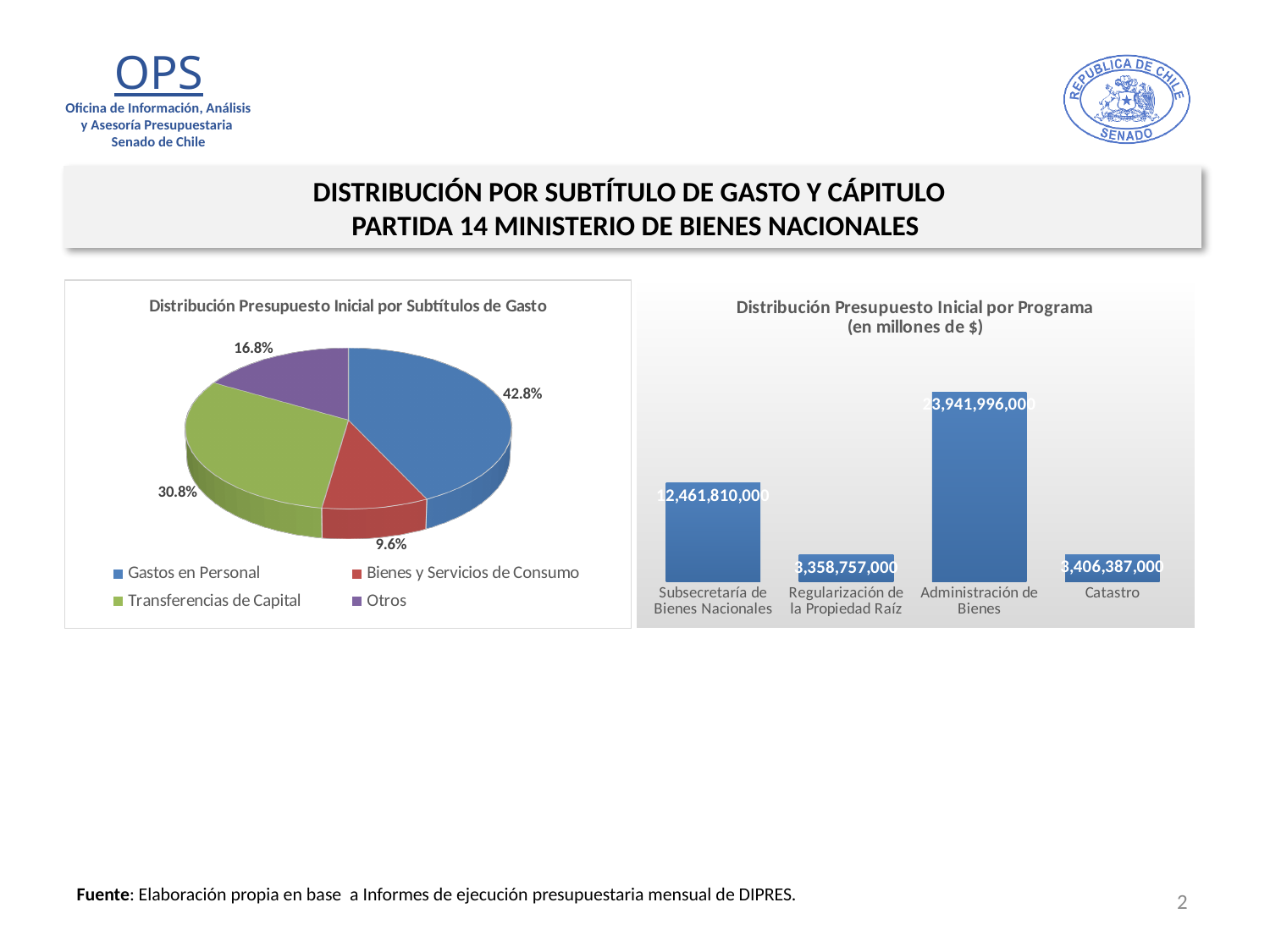
In the pie chart 'Distribución Presupuesto Inicial por Subtítulos de Gasto', which colour represents Transferencias de Capital? Green In the pie chart 'Distribución Presupuesto Inicial por Subtítulos de Gasto', what share does Transferencias de Capital have? 30.8% In the pie chart 'Distribución Presupuesto Inicial por Subtítulos de Gasto', which category has the largest share? Gastos en Personal How many programs are shown in the bar chart 'Distribución Presupuesto Inicial por Programa'? 4 In the pie chart 'Distribución Presupuesto Inicial por Subtítulos de Gasto', what share does Gastos en Personal have? 42.8% In the pie chart 'Distribución Presupuesto Inicial por Subtítulos de Gasto', how many percentage points larger is Gastos en Personal than Transferencias de Capital? 12.0 percentage points In the bar chart 'Distribución Presupuesto Inicial por Programa', which is larger: Subsecretaría de Bienes Nacionales or Administración de Bienes? Administración de Bienes In the pie chart 'Distribución Presupuesto Inicial por Subtítulos de Gasto', what share does Otros have? 16.8% What kind of chart is 'Distribución Presupuesto Inicial por Programa'? Bar chart How many slices does the pie chart 'Distribución Presupuesto Inicial por Subtítulos de Gasto' have? 4 In the pie chart 'Distribución Presupuesto Inicial por Subtítulos de Gasto', which category has the smallest share? Bienes y Servicios de Consumo In the bar chart 'Distribución Presupuesto Inicial por Programa', which program has the highest value? Administración de Bienes